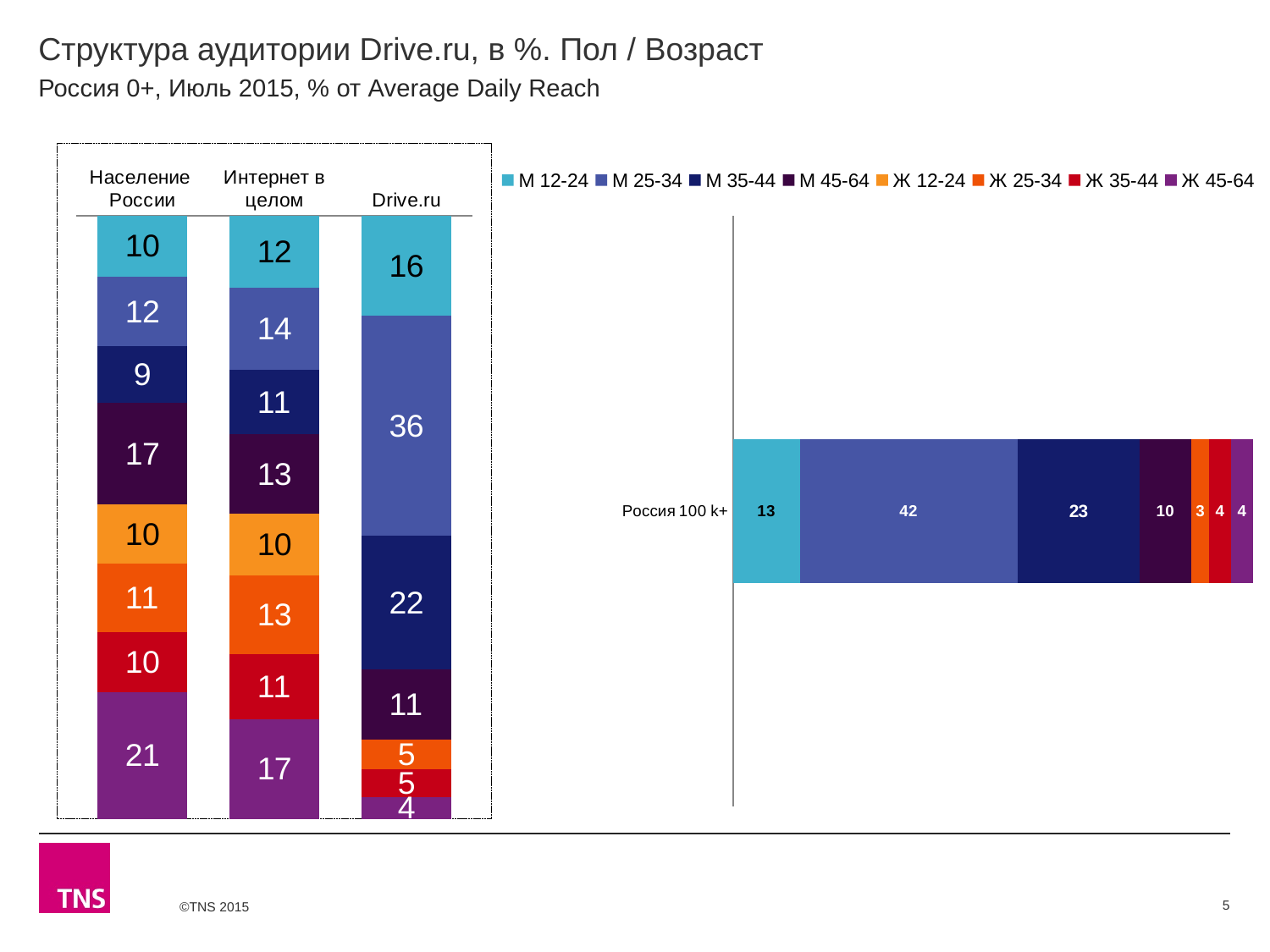
In the left chart, which bar has the larger М 35-44 value: Drive.ru or Интернет в целом? Drive.ru In the right chart (Россия 100 k+), which series has the largest segment? М 25-34 In the right chart (Россия 100 k+), what is the value for М 25-34? 42 How many series does the legend list? 8 In the right chart (Россия 100 k+), what is the difference between the М 25-34 and М 35-44 values? 19 In the left chart, which series has the largest segment in the Drive.ru bar? М 25-34 In the right chart (Россия 100 k+), what is the value for М 35-44? 23 In the left chart, what is the value for Ж 45-64 in the Население России bar? 21 In the left chart, what is the value for М 45-64 in the Интернет в целом bar? 13 In the left chart, what is the difference between the М 25-34 value for Drive.ru and the М 25-34 value for Население России? 24 How many bars (categories) are shown in the left chart? 3 In the left chart, what is the value for М 25-34 in the Drive.ru bar? 36